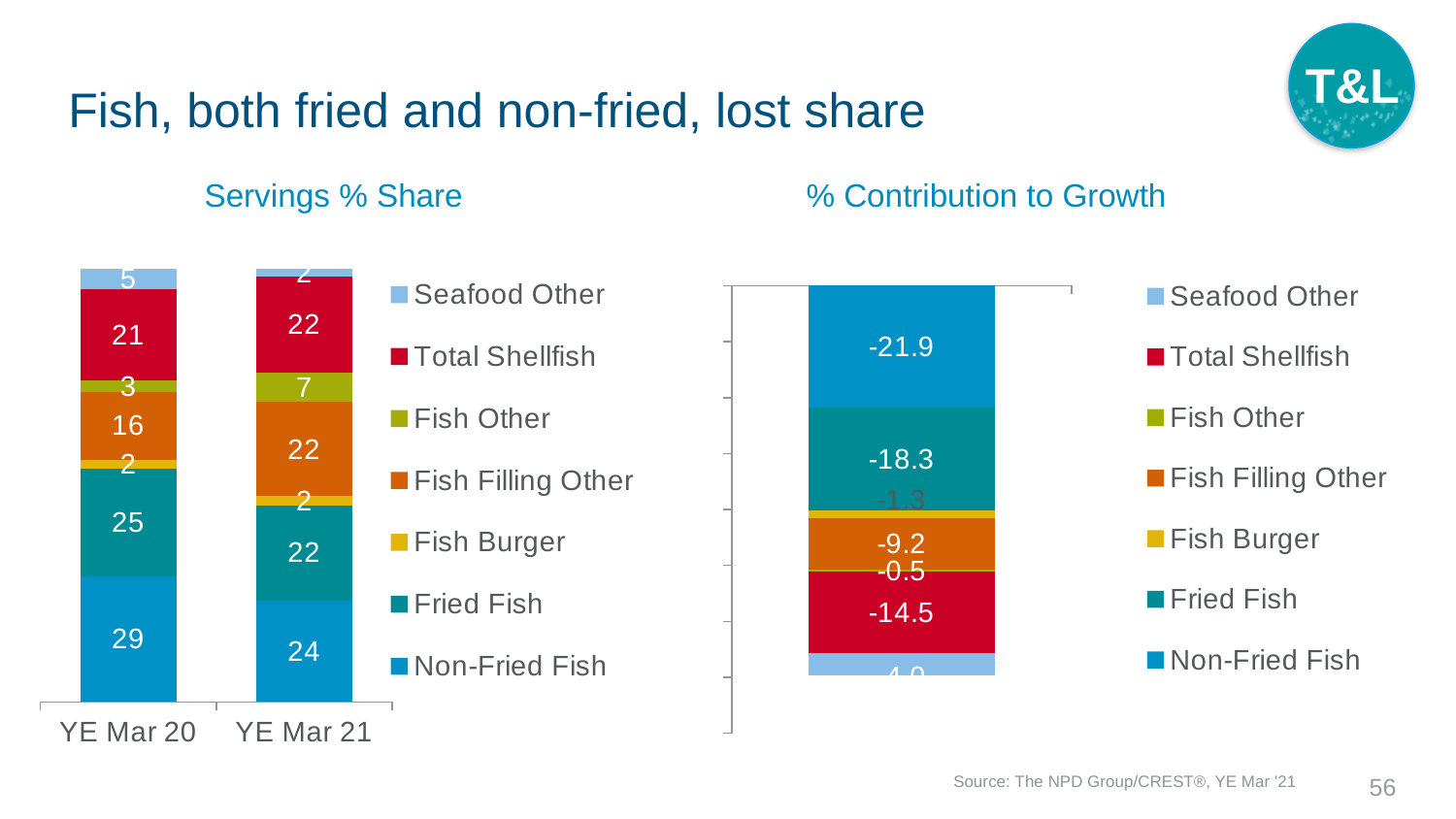
In the Servings % Share chart, by how much did the Non-Fried Fish value change from YE Mar 20 to YE Mar 21? 5 In the Servings % Share chart, what is the value for Fish Other in YE Mar 21? 7 In the Servings % Share chart, what is the value for Fried Fish in YE Mar 21? 22 How many categories are shown on the x axis of the Servings % Share chart? 2 In the Servings % Share chart, what is the value for Non-Fried Fish in YE Mar 20? 29 In the % Contribution to Growth chart, what is the value for Total Shellfish? -14.5 In the Servings % Share chart, which is larger in YE Mar 20: Fried Fish or Fish Filling Other? Fried Fish In the % Contribution to Growth chart, what is the value for Non-Fried Fish? -21.9 In the Servings % Share chart, what is the value for Fish Filling Other in YE Mar 20? 16 How many series does the legend of the Servings % Share chart list? 7 In the % Contribution to Growth chart, which series has the lowest (most negative) value? Non-Fried Fish What kind of chart is the Servings % Share chart? Stacked bar chart